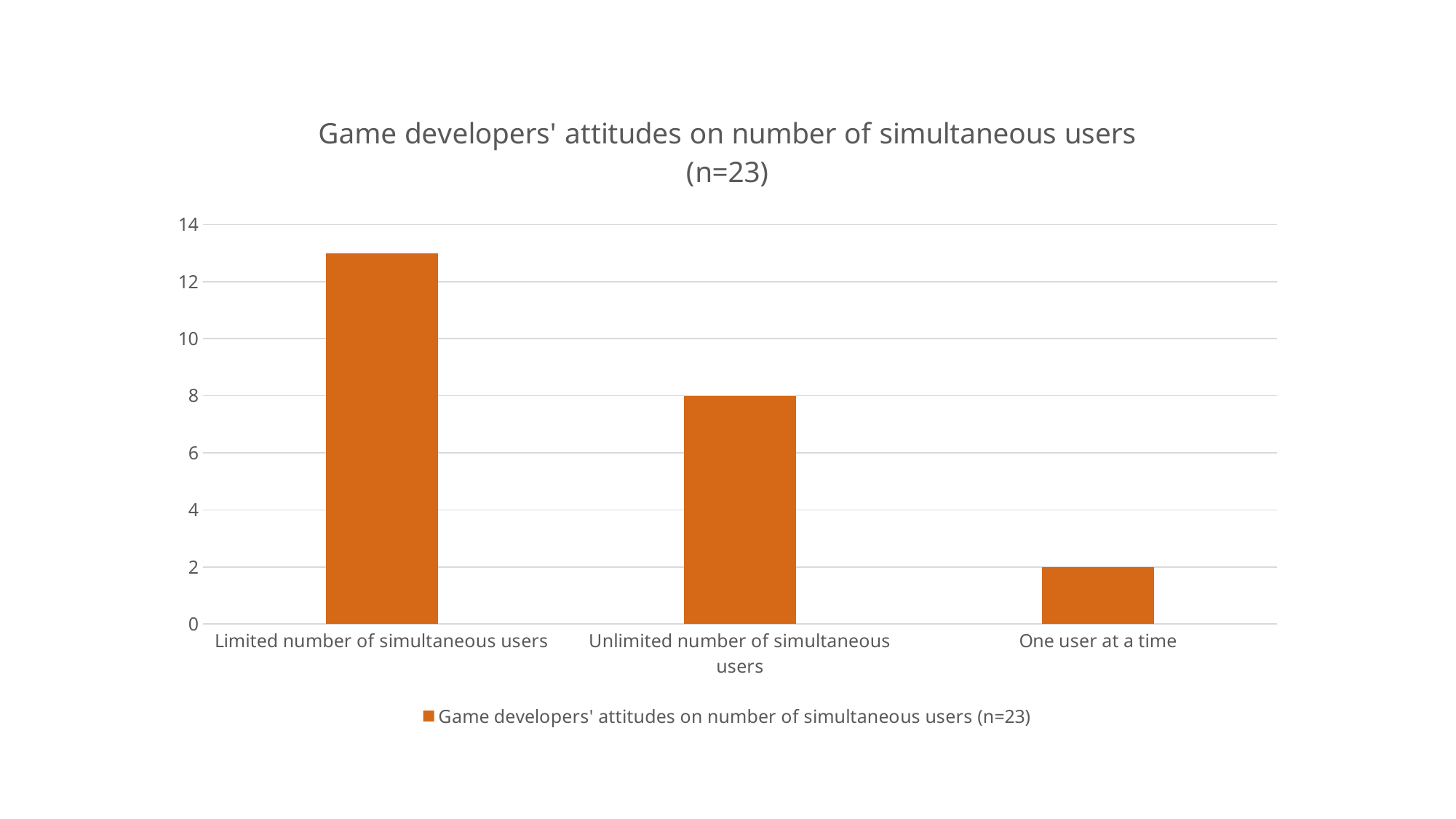
How many series does the legend list? 1 Is the value for 'Limited number of simultaneous users' greater or less than 12? greater Is the value for 'Unlimited number of simultaneous users' greater or less than 10? less What is the value for 'Unlimited number of simultaneous users'? 8 Which category has the lowest value? One user at a time What type of chart is shown on the slide? bar chart Which is larger: the value for 'Limited number of simultaneous users' or 'Unlimited number of simultaneous users'? Limited number of simultaneous users What is the title of the chart? Game developers' attitudes on number of simultaneous users (n=23) What is the difference between the values for 'Unlimited number of simultaneous users' and 'One user at a time'? 6 Which category has the highest value? Limited number of simultaneous users How many categories are shown on the x axis? 3 What is the value for 'One user at a time'? 2